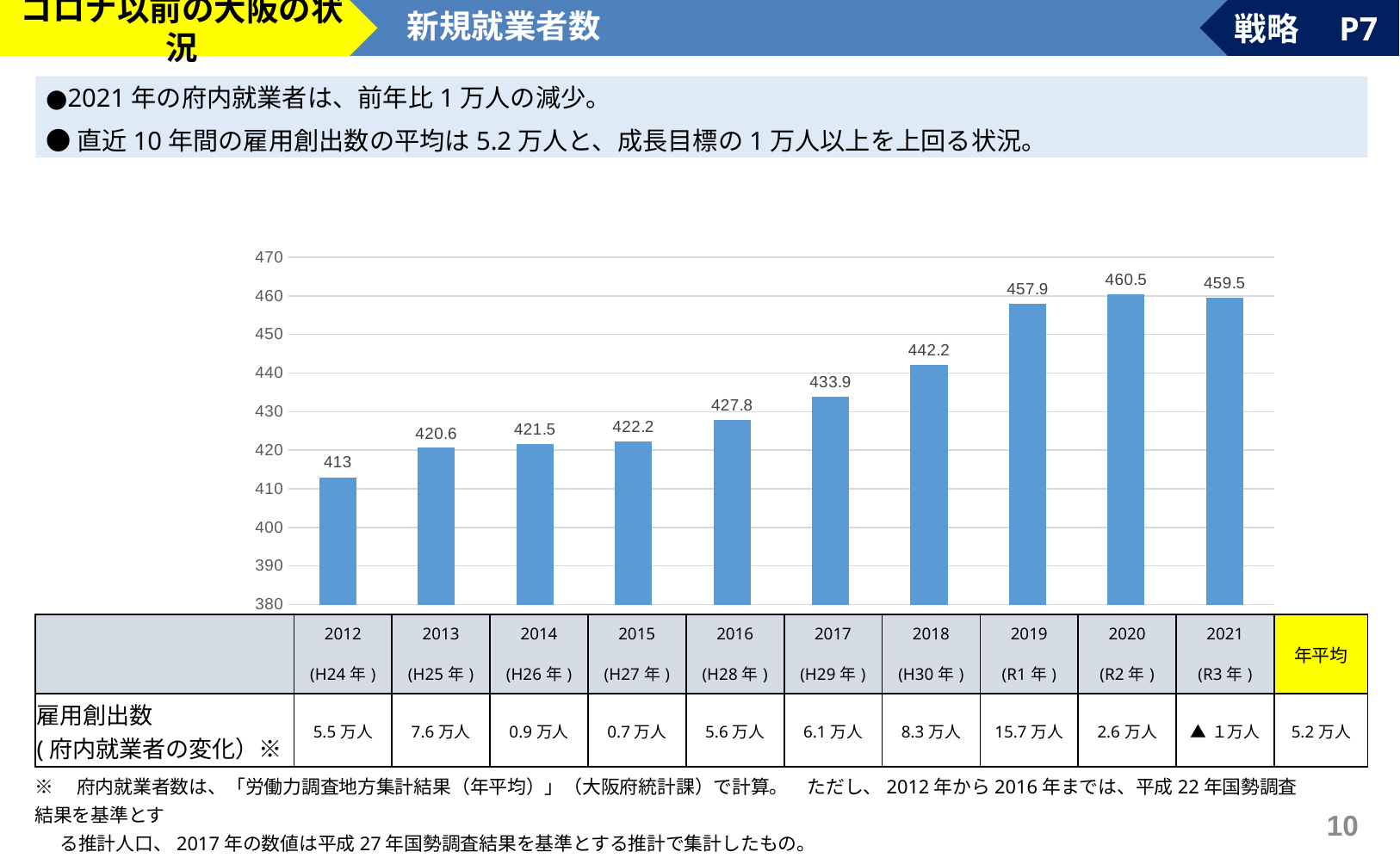
What is the value of the bar for 2018? 442.2 What is the difference between the values for 2019 and 2018? 15.7 What is the value of the bar for 2012? 413 Do the values generally rise or fall from 2012 to 2020? rise What is the value of the bar for 2021? 459.5 Is the value for 2015 greater or less than 430? less Which year has the lowest bar? 2012 What is the difference between the values for 2020 and 2021? 1 What kind of chart is shown on the slide? bar chart How many bars are plotted in the chart? 10 Which year has the highest bar? 2020 Which is larger, the value for 2016 or the value for 2017? 2017